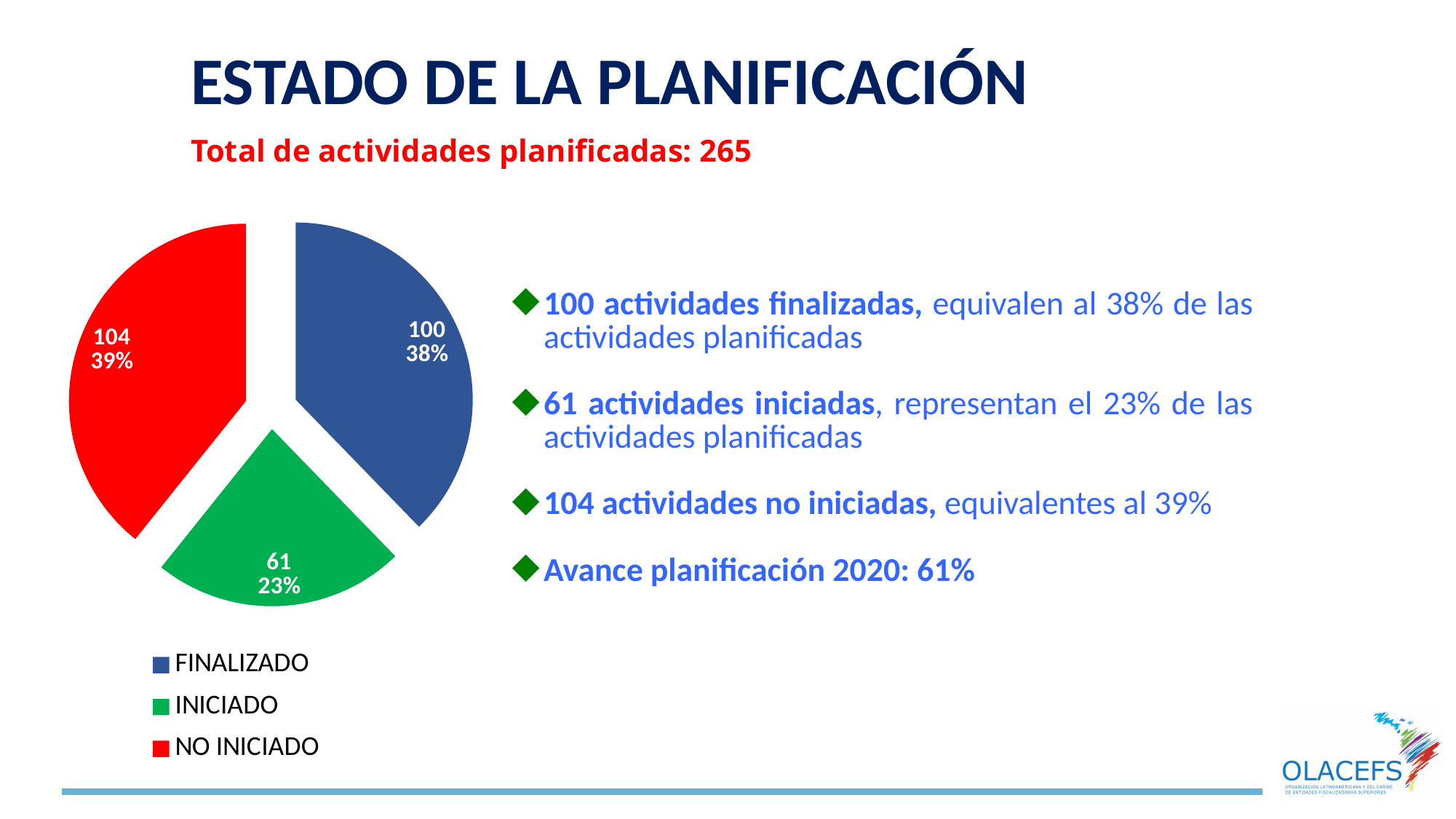
Which is larger, the value for FINALIZADO or the value for INICIADO? FINALIZADO Which category has the lowest value? INICIADO How many entries does the legend list? 3 What is the difference between the values for NO INICIADO and INICIADO? 43 What is the value for NO INICIADO? 104 What is the value for INICIADO? 61 What share of the pie does INICIADO represent? 23% What is the value for FINALIZADO? 100 What colour is the NO INICIADO slice? red How many slices does the pie chart have? 3 What share of the pie does NO INICIADO represent? 39% What kind of chart is shown on the slide? pie chart